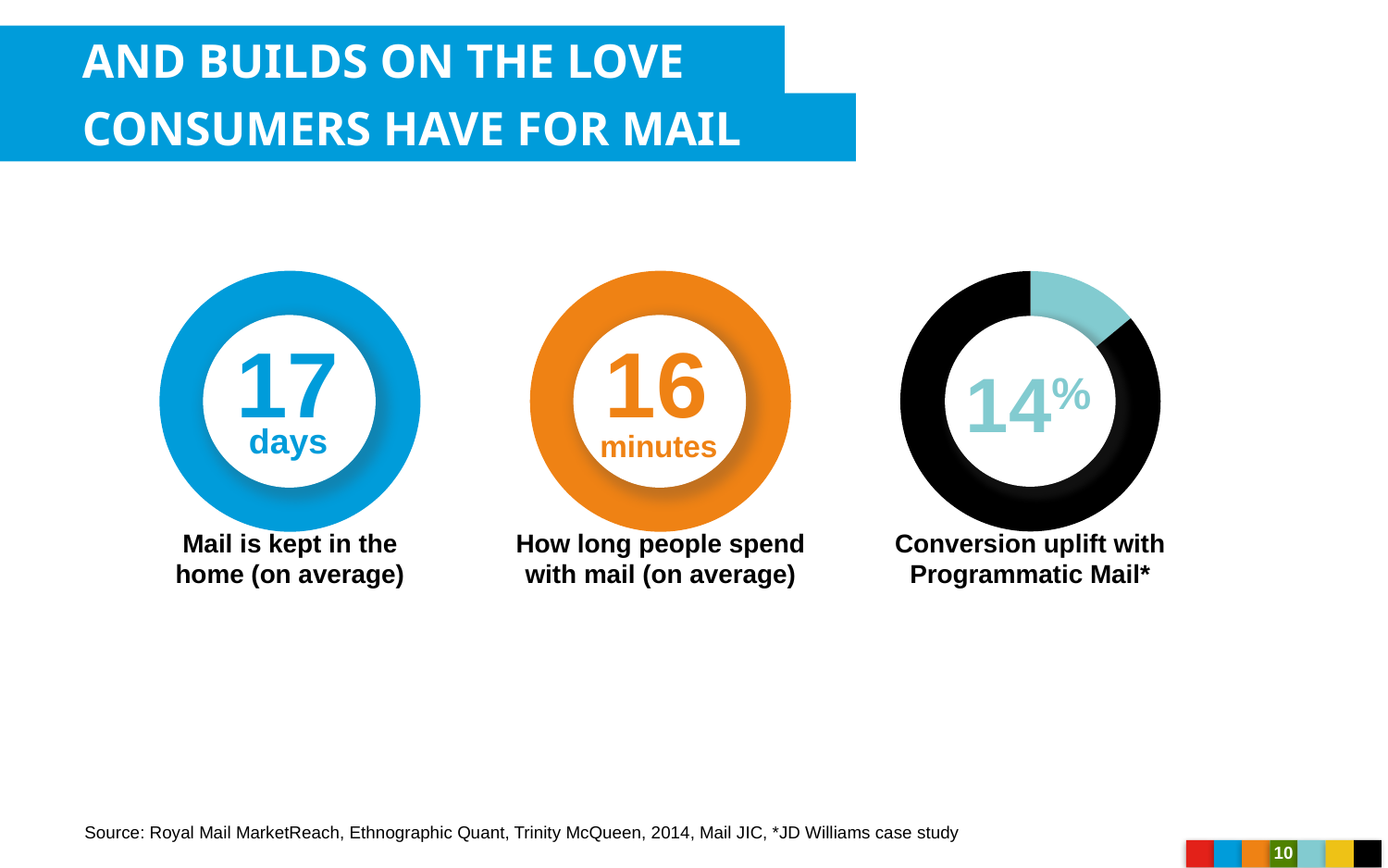
What share of the right-hand doughnut chart does the highlighted light-blue slice represent? 14% What value is shown in the left-hand blue circle for how long mail is kept in the home on average? 17 days On the right-hand doughnut chart, what value is printed in the centre? 14% What kind of chart is the right-hand graphic labelled 'Conversion uplift with Programmatic Mail*'? Doughnut (pie) chart On the right-hand doughnut chart, is the highlighted light-blue slice greater or less than 50% of the ring? less What value is shown in the middle orange circle for how long people spend with mail on average? 16 minutes Which is larger: the number in the left-hand circle (days) or the number in the middle circle (minutes)? The left-hand circle (17) What colour is the highlighted slice on the right-hand doughnut chart? Light blue How many circular graphics are shown on the slide? 3 On the right-hand doughnut chart, what share of the ring is the dark (non-highlighted) portion? 86% What does the right-hand doughnut chart represent, according to its caption? Conversion uplift with Programmatic Mail*